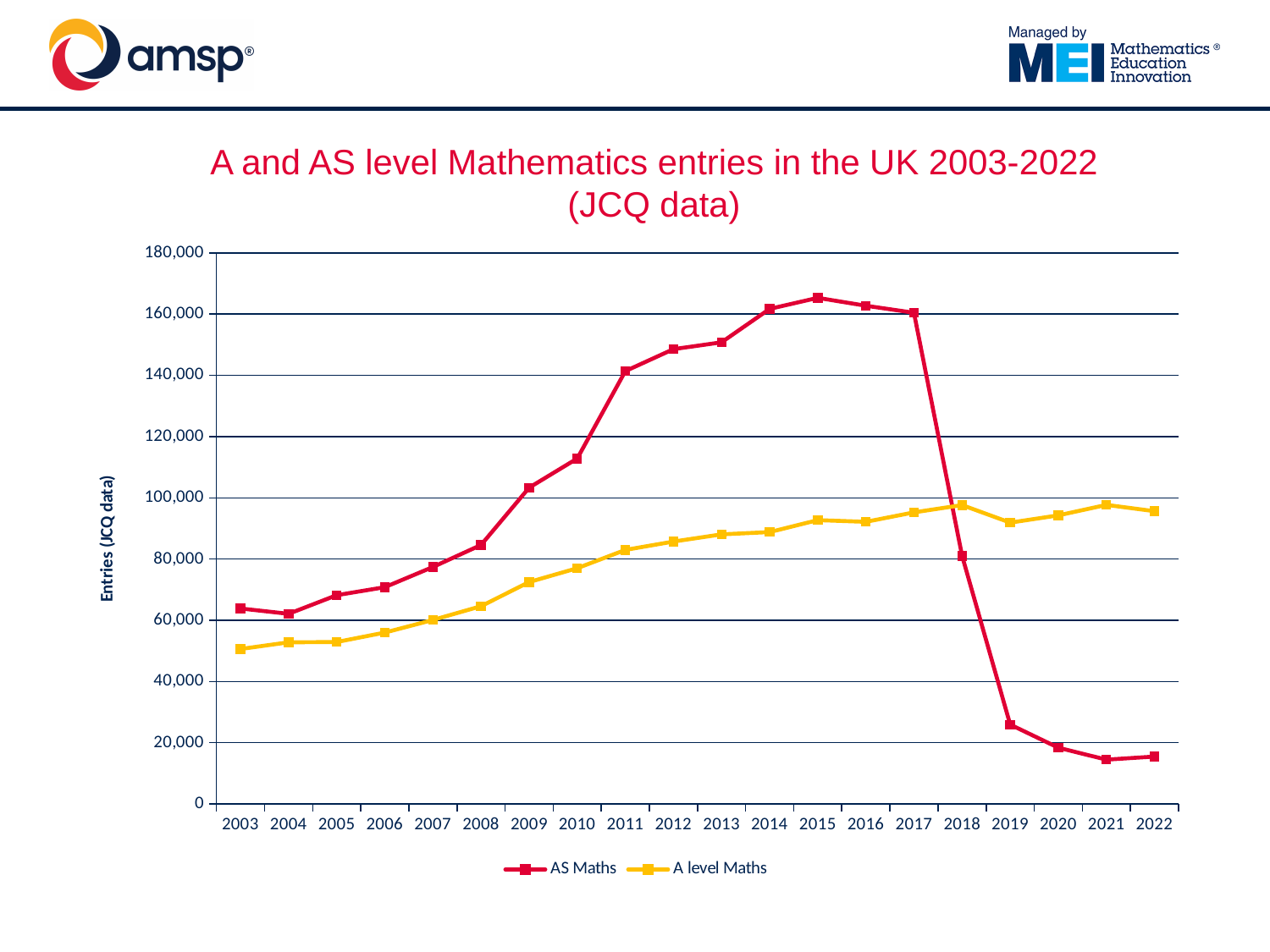
In which year is the A level Maths series at its lowest? 2003 How many years are plotted along the x axis? 20 Does the AS Maths series rise or fall between 2017 and 2021? Fall Is the value for AS Maths in 2015 greater or less than 160,000? greater In which year does the AS Maths series reach its highest value? 2015 In 2019, which series has the larger value, AS Maths or A level Maths? A level Maths Is the value for A level Maths in 2022 greater or less than 100,000? less Is the value for AS Maths in 2019 greater or less than 40,000? less In which year does the AS Maths series reach its lowest value? 2021 How many series does the legend list? 2 In 2010, which series has the larger value, AS Maths or A level Maths? AS Maths What kind of chart is shown on the slide? Line chart